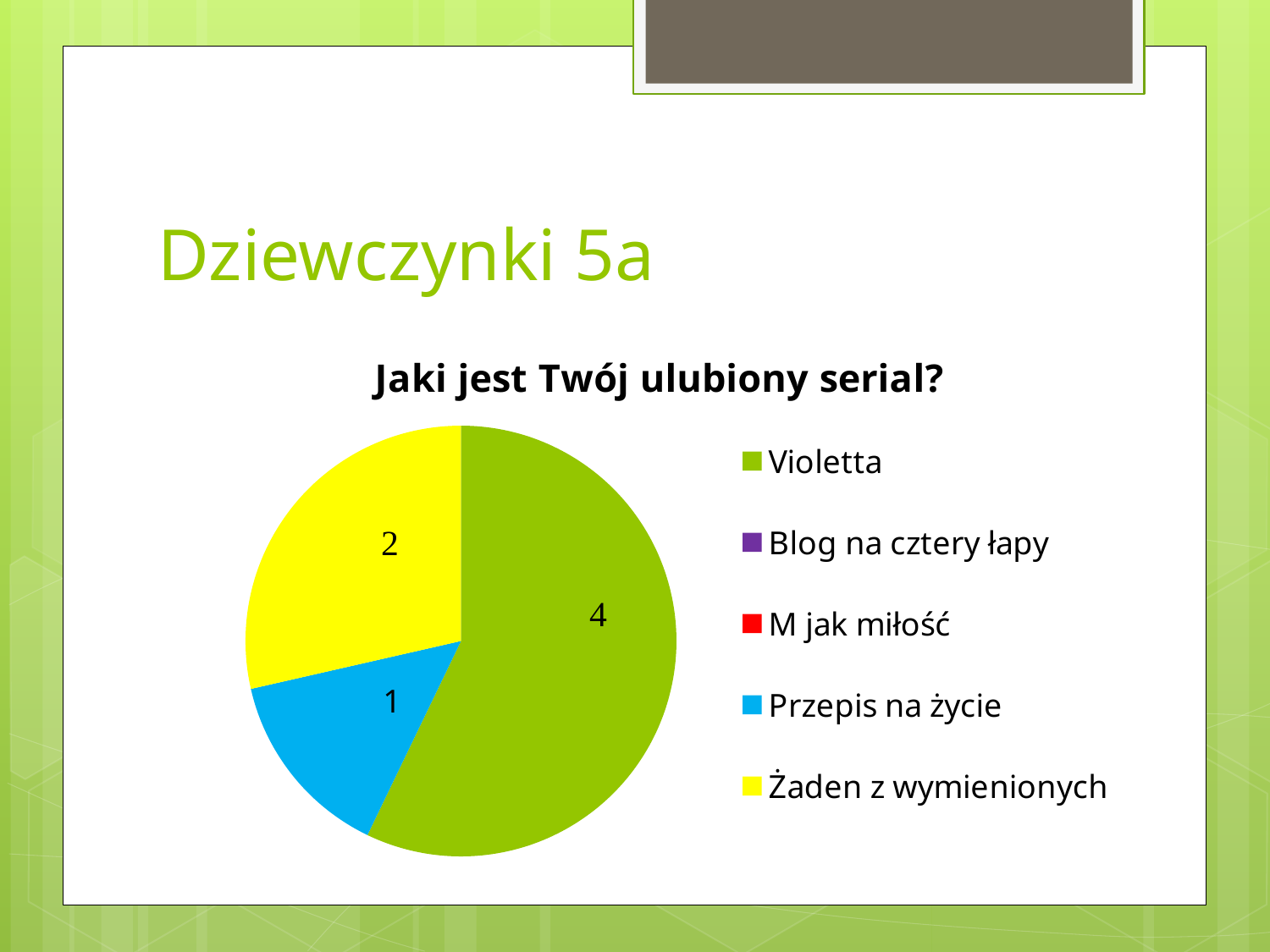
Which category has the largest slice of the pie? Violetta What colour is the slice for Violetta? green Which is larger, the value for Żaden z wymienionych or the value for Przepis na życie? Żaden z wymienionych What kind of chart is shown on the slide? pie chart What is the value for Przepis na życie? 1 What is the title of the chart? Jaki jest Twój ulubiony serial? What is the difference between the values for Violetta and Żaden z wymienionych? 2 What is the value for Żaden z wymienionych? 2 How many slices with a data label are visible in the pie chart? 3 Which of the labelled slices is the smallest? Przepis na życie How many entries does the chart legend list? 5 What is the value for Violetta? 4